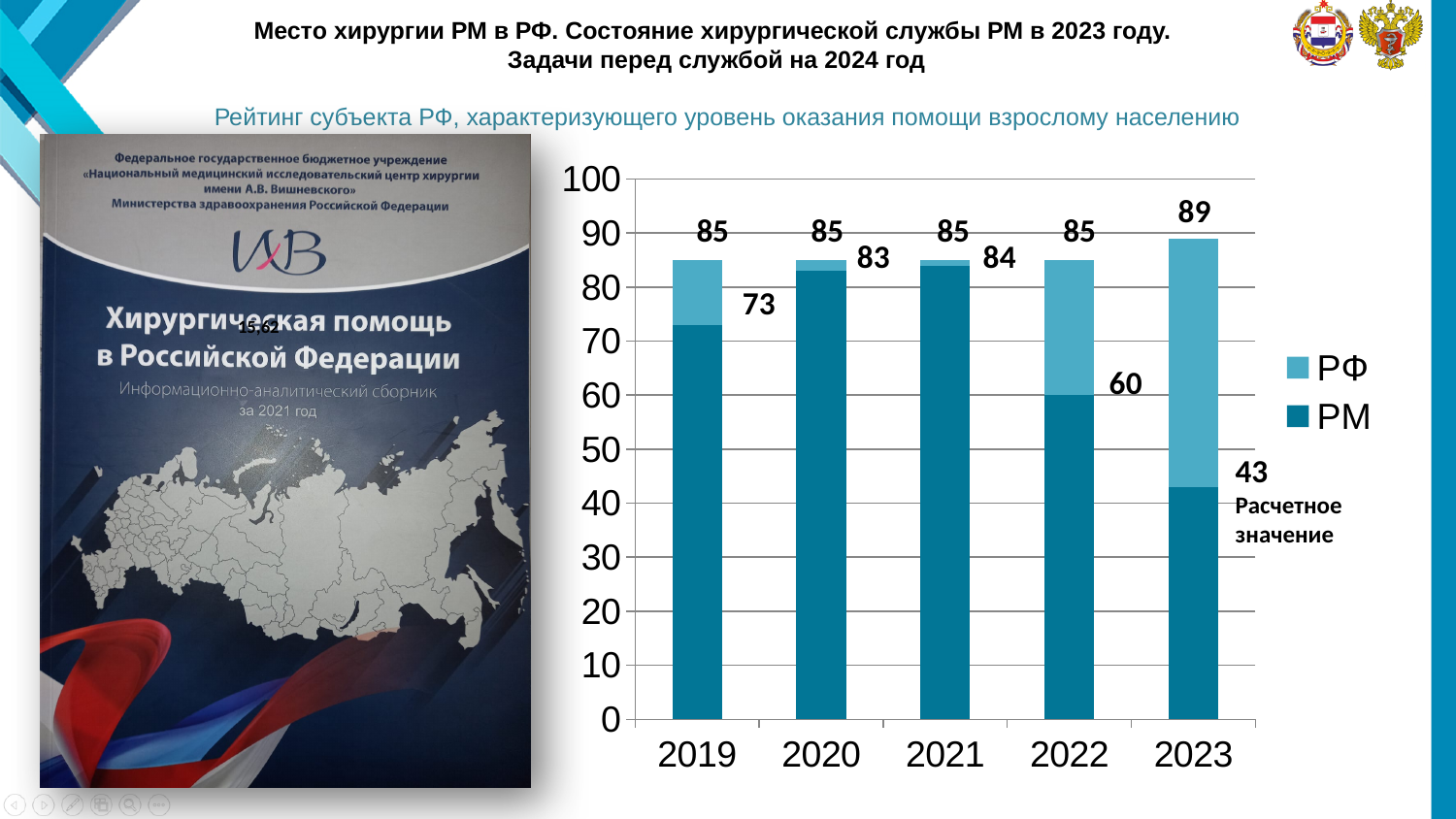
In which year is the РФ value highest? 2023 By how much did the РМ value fall from 2021 to 2022? 24 What is the value for РМ in 2019? 73 What is the value for РМ in 2023? 43 What is the difference between the РФ and РМ values in 2023? 46 What is the value for РФ in 2023? 89 What kind of chart is shown on the slide? bar chart In which year is the РМ value lowest? 2023 How many series does the legend list? 2 How many years are shown on the x axis? 5 Which is larger, the РМ value in 2020 or in 2021? 2021 What is the value for РМ in 2022? 60